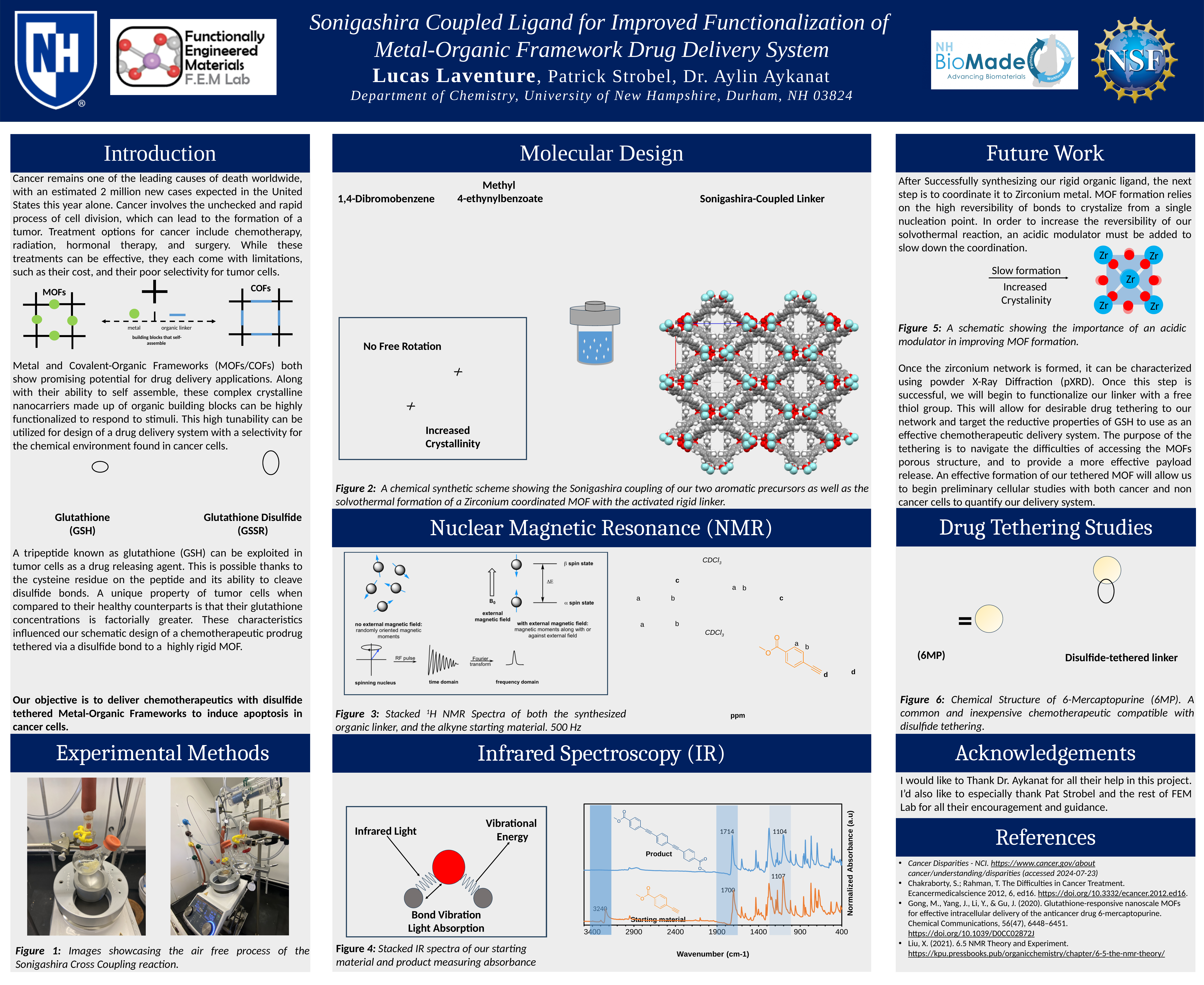
In the Infrared Spectroscopy (IR) chart, which labeled carbonyl peak has the higher wavenumber, the Product's or the Starting material's? Product (1714) In the Infrared Spectroscopy (IR) chart, is the labeled Starting material peak at 3240 greater or less than 2900 on the wavenumber axis? greater In the Infrared Spectroscopy (IR) chart (Figure 4), what kind of chart is shown? line chart In the Infrared Spectroscopy (IR) chart, what wavenumber is labeled on the Product peak near 1100 cm-1? 1104 In the Infrared Spectroscopy (IR) chart, what wavenumber is labeled on the strong peak of the Product spectrum near 1700 cm-1? 1714 In the Infrared Spectroscopy (IR) chart, what is the label of the x axis? Wavenumber (cm-1) In the Infrared Spectroscopy (IR) chart, what is the difference between the labeled peaks at 1107 (Starting material) and 1104 (Product)? 3 In the Infrared Spectroscopy (IR) chart, what wavenumber is labeled on the Starting material peak at the high-wavenumber end of the spectrum? 3240 In the Infrared Spectroscopy (IR) chart, how many tick labels are shown on the wavenumber (x) axis? 7 In the Infrared Spectroscopy (IR) chart, what is the difference between the labeled carbonyl peak of the Product (1714) and that of the Starting material (1700)? 14 In the Infrared Spectroscopy (IR) chart, how many spectra (series) are plotted? 2 In the Infrared Spectroscopy (IR) chart, what wavenumber is labeled on the strong peak of the Starting material spectrum near 1700 cm-1? 1700